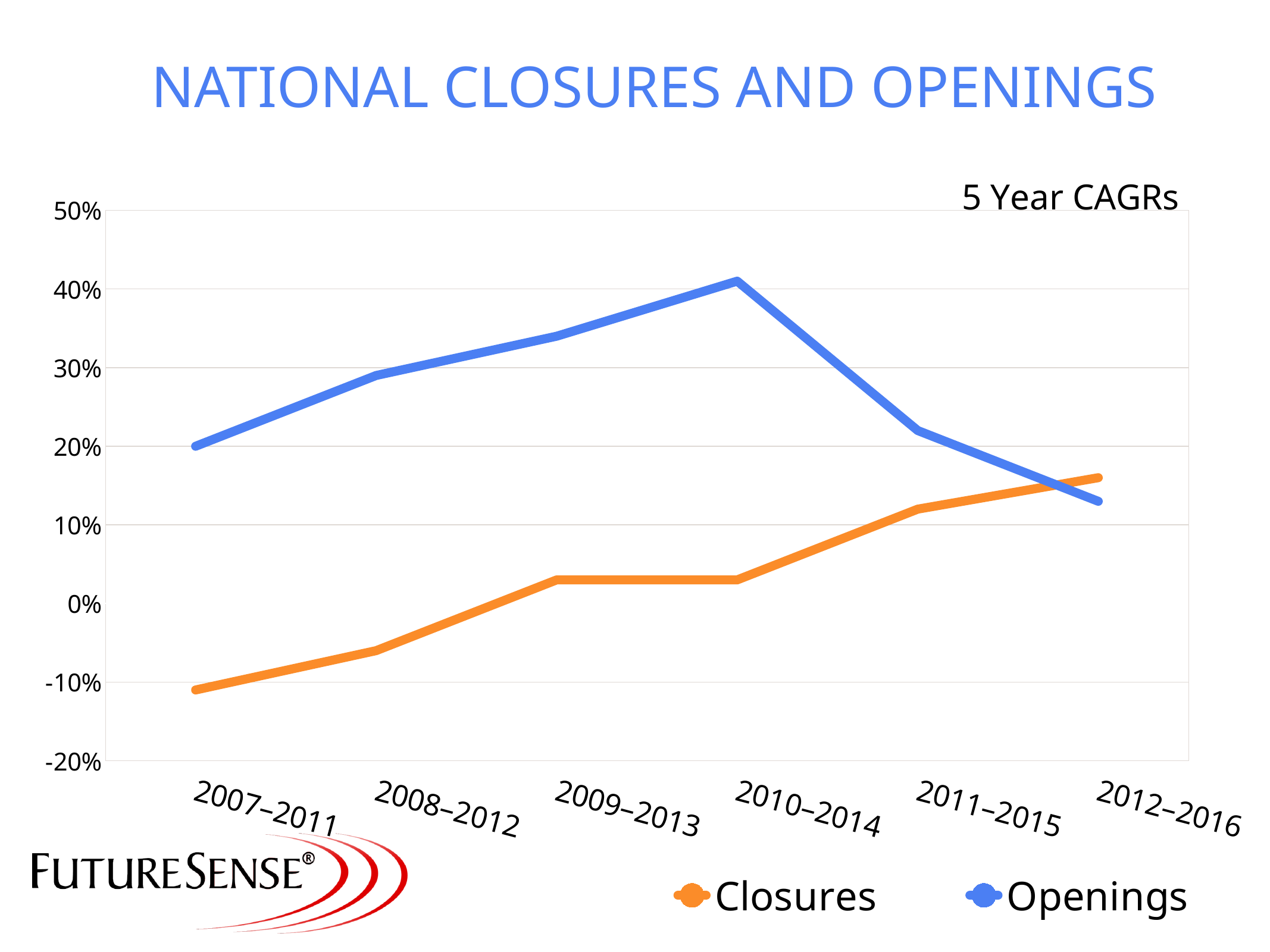
Which series has the higher value in 2007-2011, Closures or Openings? Openings Is the value for Openings in 2010-2014 greater or less than 30%? greater What kind of chart is shown on the slide? line chart How many time periods are shown on the x axis? 6 How many series does the legend list? 2 Is the value for Closures in 2007-2011 greater or less than 0%? less In which period is the Closures series at its lowest value? 2007-2011 What label appears above the top right of the plot area? 5 Year CAGRs Is the value for Closures in 2012-2016 greater or less than 10%? greater Does the Closures series generally rise or fall from 2007-2011 to 2012-2016? rise In which period does the Openings series reach its highest value? 2010-2014 In which period is the Closures series at its highest value? 2012-2016